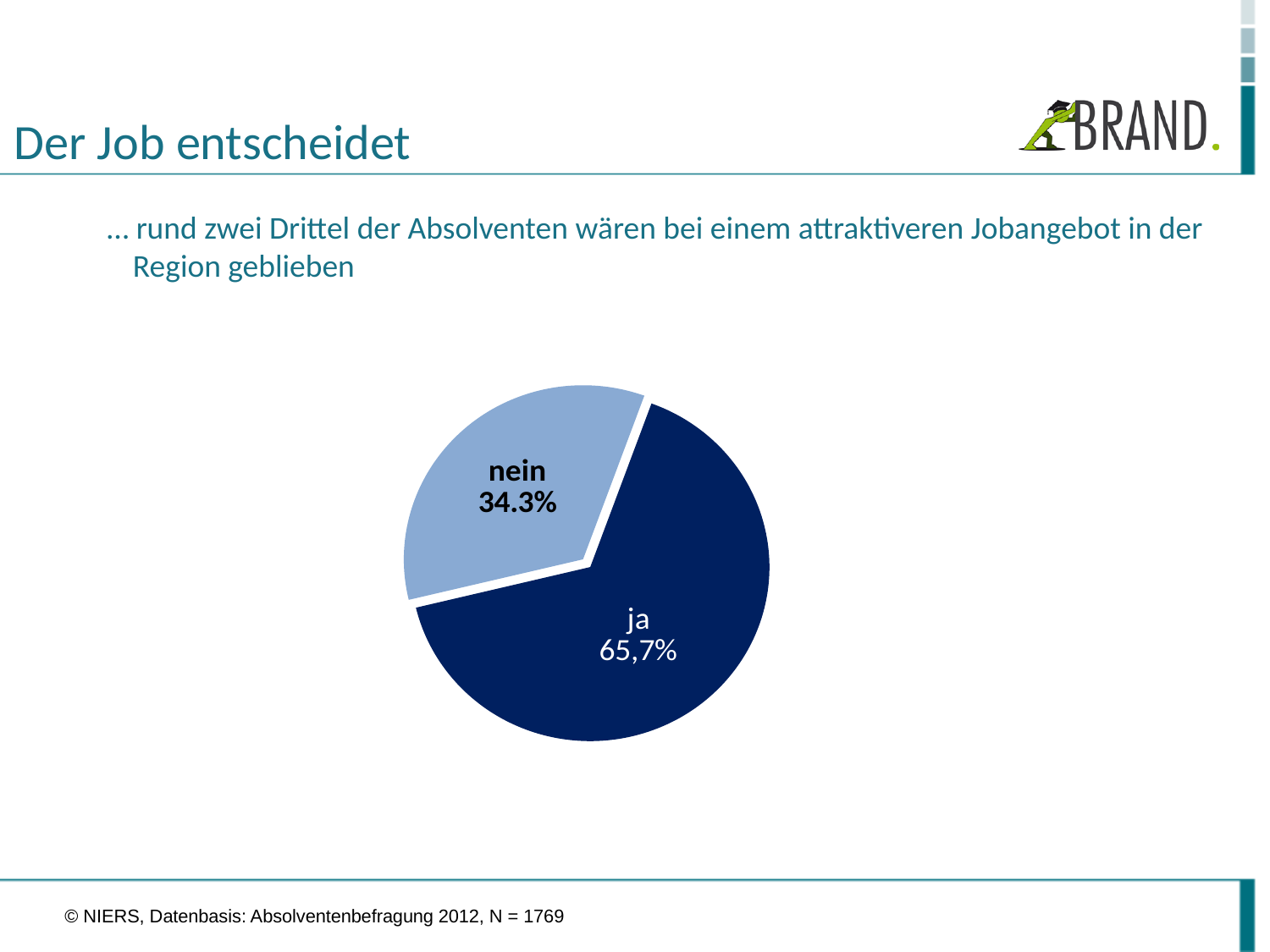
What is the value shown for the "nein" slice? 34.3% Which slice is the smallest in the pie chart? nein Which slice is the largest in the pie chart? ja What is the value shown for the "ja" slice? 65,7% What share of the pie does the "ja" slice represent? 65,7% What is the title of the slide containing the pie chart? Der Job entscheidet Which slice of the pie chart is shown in light blue? nein How many slices does the pie chart have? 2 What share of the pie does the "nein" slice represent? 34.3% Which is larger, the "ja" slice or the "nein" slice? ja What kind of chart is shown on the slide? pie chart Which slice of the pie chart is shown in dark blue? ja